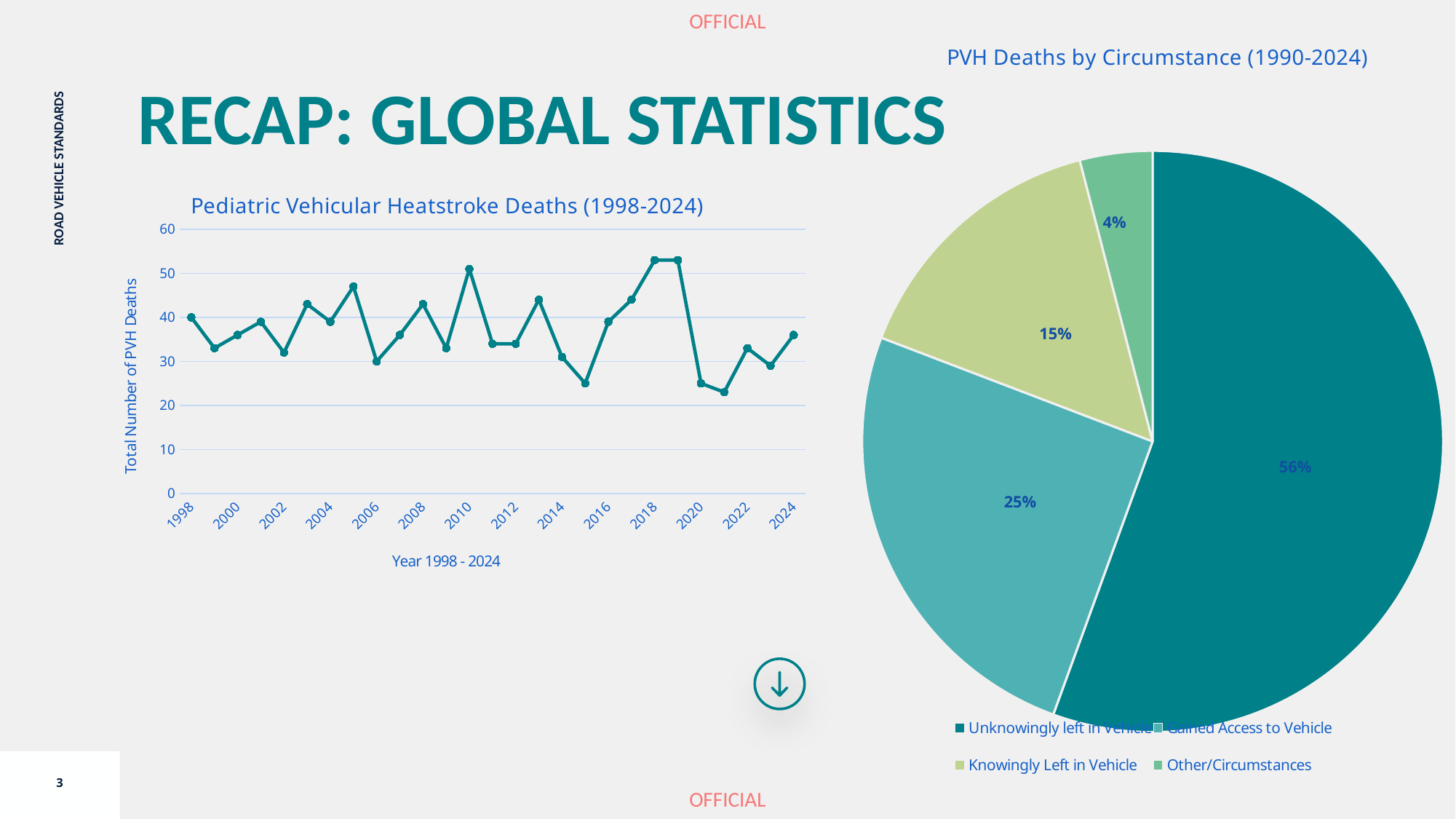
In the line chart 'Pediatric Vehicular Heatstroke Deaths (1998-2024)', is the value for 2018 greater or less than 50? greater What kind of chart is 'Pediatric Vehicular Heatstroke Deaths (1998-2024)'? line chart In the pie chart 'PVH Deaths by Circumstance (1990-2024)', which circumstance has the smallest slice? Other/Circumstances In the line chart 'Pediatric Vehicular Heatstroke Deaths (1998-2024)', what is the label of the vertical axis? Total Number of PVH Deaths In the line chart 'Pediatric Vehicular Heatstroke Deaths (1998-2024)', is the value for 2021 greater or less than 30? less In the pie chart 'PVH Deaths by Circumstance (1990-2024)', what share is labelled for Gained Access to Vehicle? 25% In the pie chart 'PVH Deaths by Circumstance (1990-2024)', which circumstance has the largest slice? Unknowingly left in Vehicle In the pie chart 'PVH Deaths by Circumstance (1990-2024)', how many categories does the legend list? 4 In the pie chart 'PVH Deaths by Circumstance (1990-2024)', how many percentage points larger is the Unknowingly left in Vehicle slice than the Gained Access to Vehicle slice? 31 In the pie chart 'PVH Deaths by Circumstance (1990-2024)', what share is labelled for Unknowingly left in Vehicle? 56% In the pie chart 'PVH Deaths by Circumstance (1990-2024)', what share is labelled for Knowingly Left in Vehicle? 15%